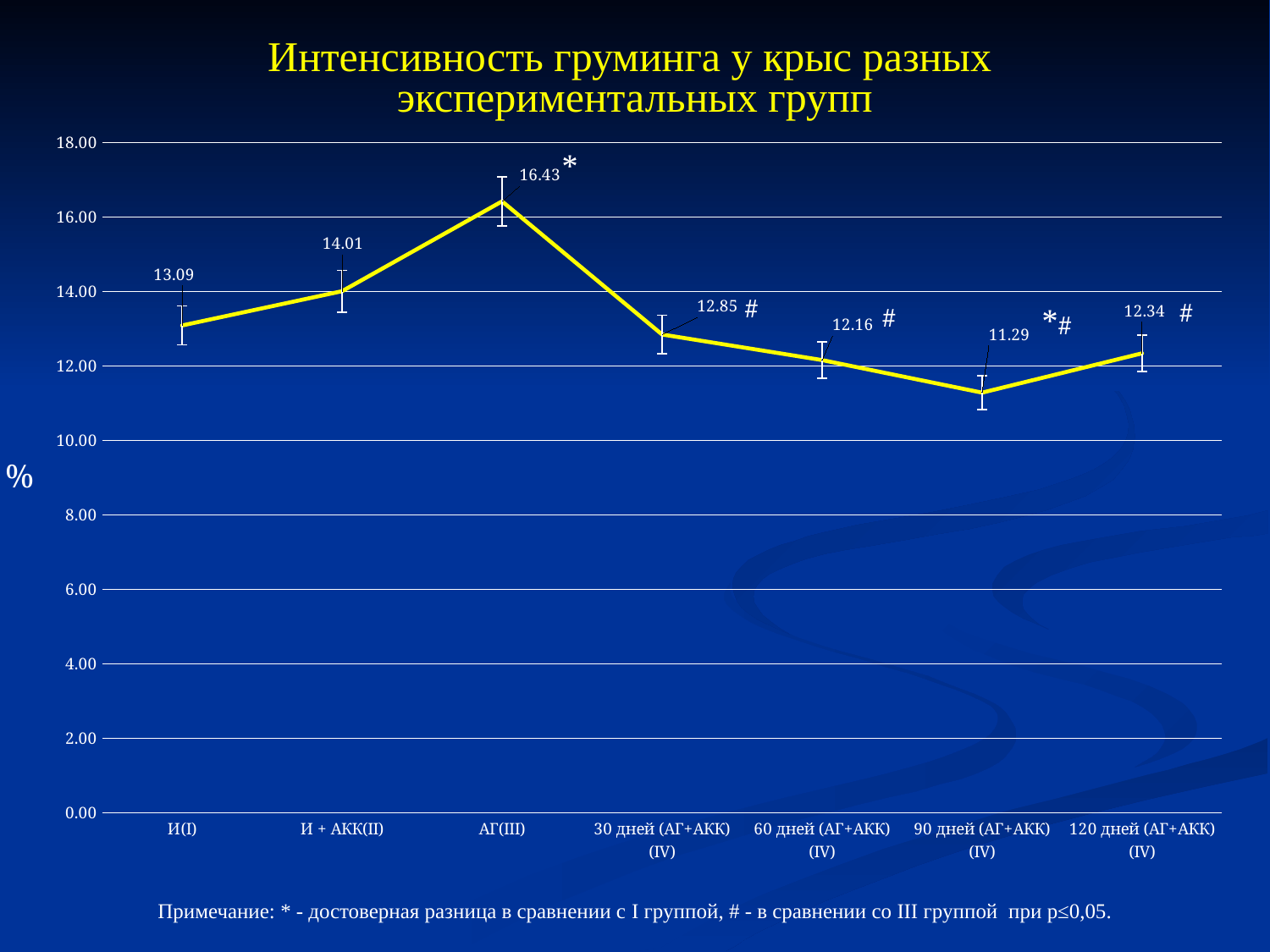
Which category has the lowest value? 90 дней (АГ+АКК) (IV) What is the value for И(I)? 13.09 What is the value for 60 дней (АГ+АКК) (IV)? 12.16 Is the value for 120 дней (АГ+АКК) (IV) greater or less than 14.00? less How many categories are plotted on the x axis? 7 What kind of chart is shown on the slide? line chart What is the title of the chart? Интенсивность груминга у крыс разных экспериментальных групп Which category has the highest value? АГ(III) What is the difference between the values for АГ(III) and И(I)? 3.34 Which is larger, the value for И + АКК(II) or the value for 30 дней (АГ+АКК) (IV)? И + АКК(II) What is the value for АГ(III)? 16.43 What is the value for 90 дней (АГ+АКК) (IV)? 11.29